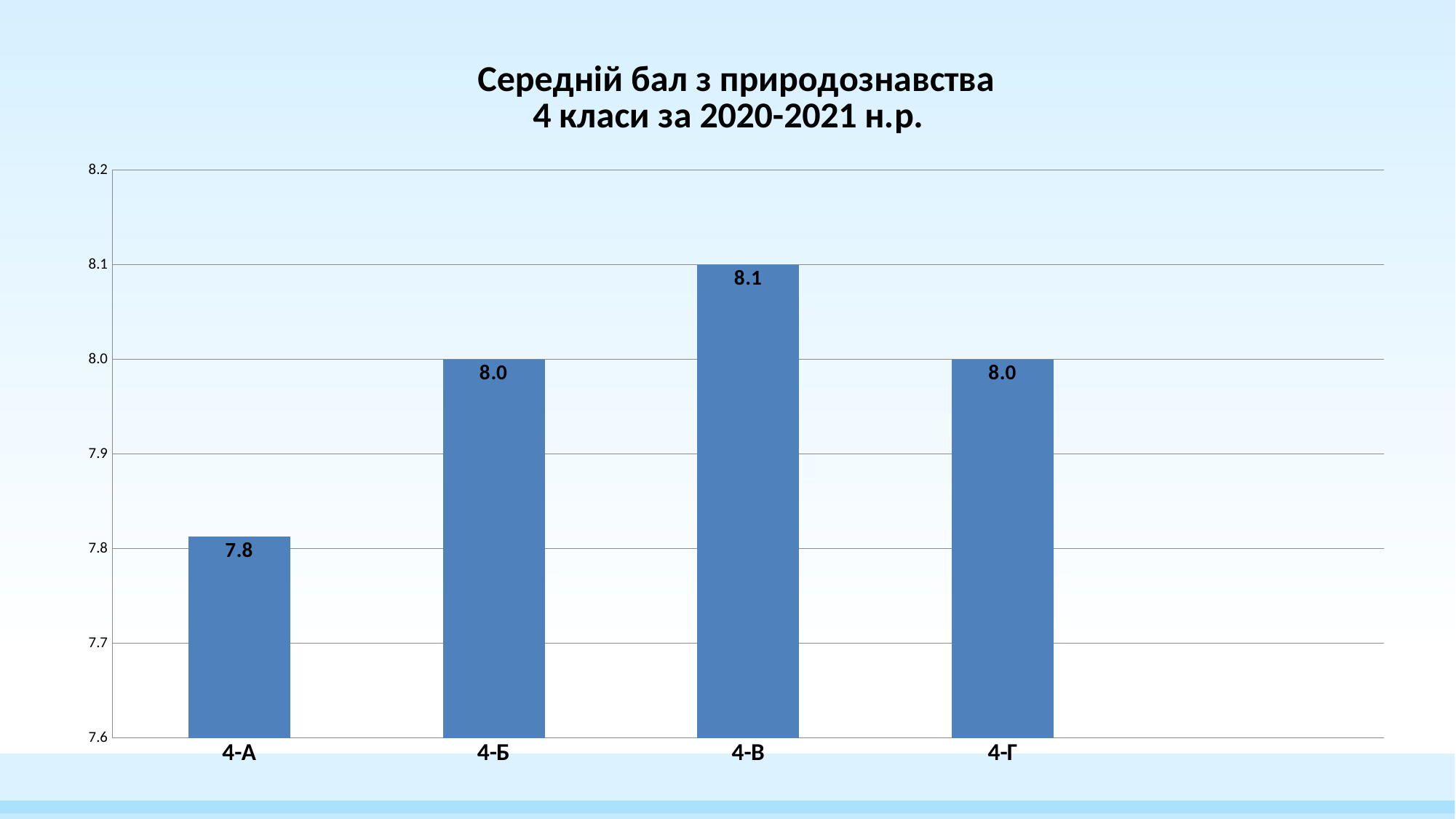
Which class has the highest average score? 4-В What is the value for 4-В? 8.1 Which is larger, the value for 4-Б or the value for 4-А? 4-Б What is the value for 4-А? 7.8 What is the value for 4-Г? 8.0 Which class has the lowest average score? 4-А What is the title of the chart? Середній бал з природознавства 4 класи за 2020-2021 н.р. What kind of chart is shown on the slide? bar chart What is the value for 4-Б? 8.0 How many classes are shown on the chart? 4 What is the difference between the values for 4-В and 4-А? 0.3 Is the value for 4-А greater or less than 7.9? less